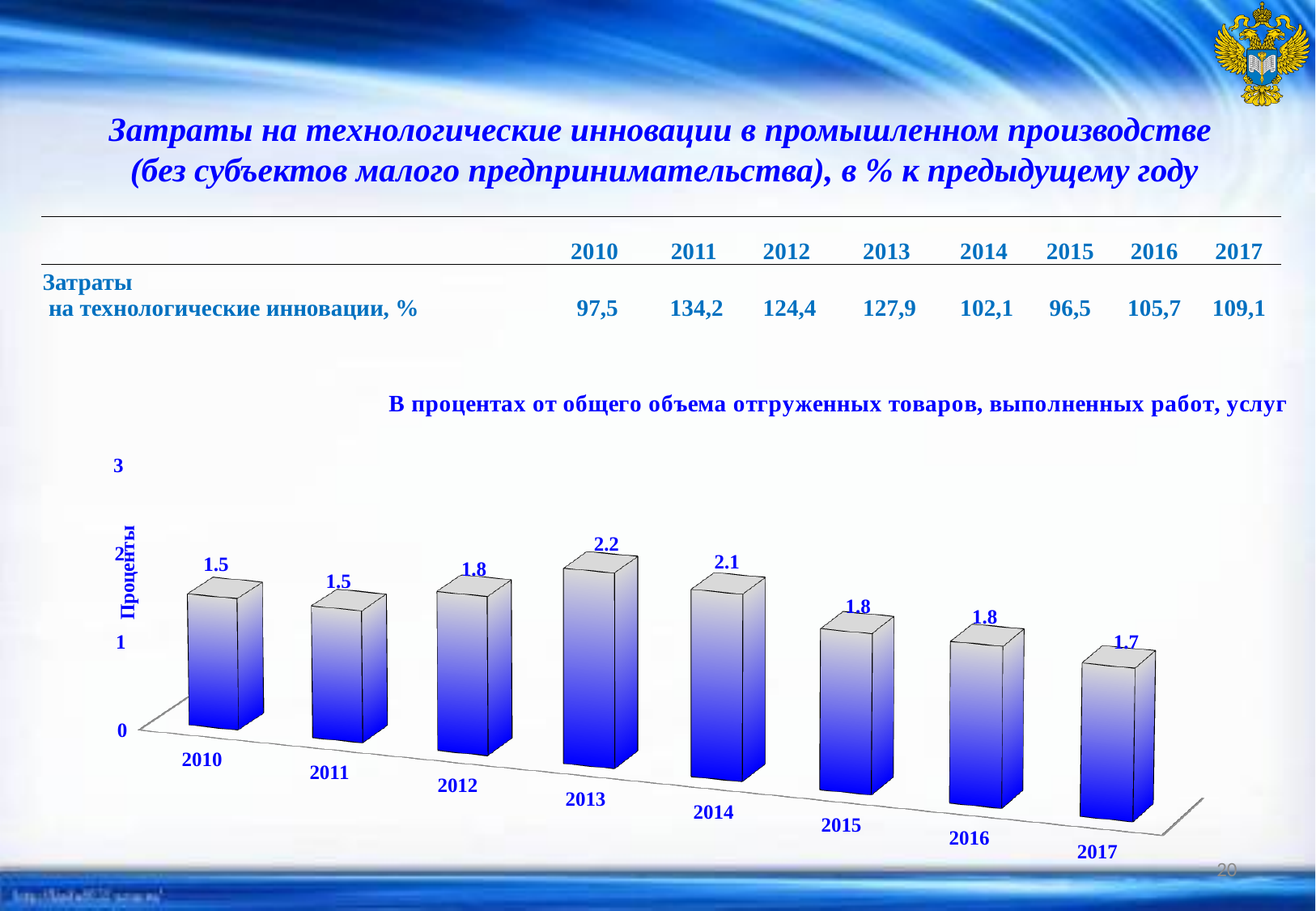
What is the value for 2013 in the bar chart? 2.2 Is the value for 2013 in the bar chart greater or less than 2? greater How many years are shown in the bar chart? 8 What is the value for 2014 in the bar chart? 2.1 What is the difference between the values for 2014 and 2017 in the bar chart? 0.4 Do the values in the bar chart rise or fall from 2013 to 2017? fall What kind of chart is shown on the slide? bar chart What is the difference between the values for 2013 and 2010 in the bar chart? 0.7 Which year has the highest value in the bar chart? 2013 What is the value for 2017 in the bar chart? 1.7 What is the value for 2010 in the bar chart? 1.5 In the bar chart, which is larger: the value for 2013 or the value for 2017? 2013